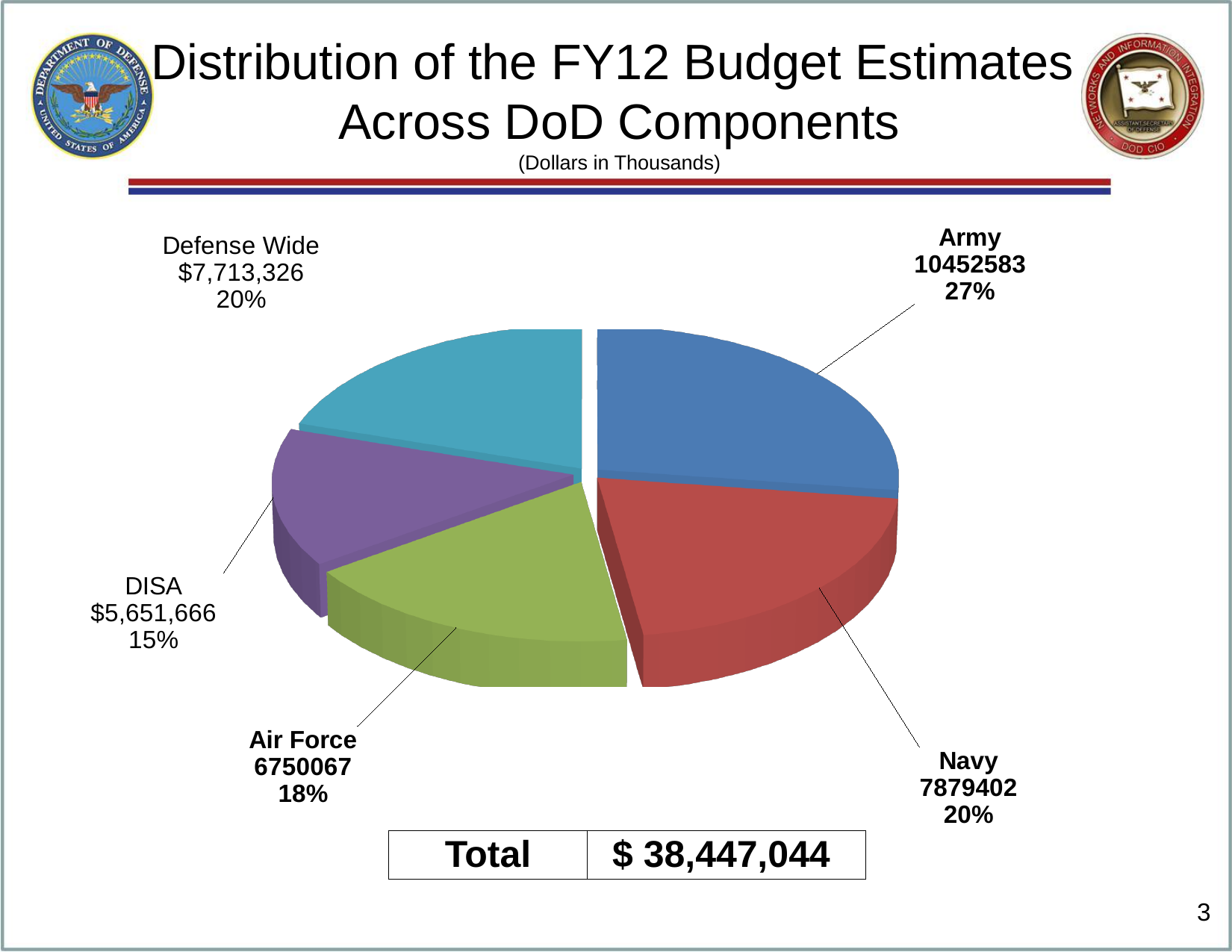
What is the budget estimate value shown for DISA? $5,651,666 What kind of chart is shown on the slide? pie chart What is the budget estimate value shown for Defense Wide? $7,713,326 Which component has the smallest share of the FY12 budget estimates? DISA How many components (slices) does the pie chart show? 5 What total is shown in the box below the pie chart? $ 38,447,044 What percentage share of the pie does the Air Force slice represent? 18% Which component has the largest share of the FY12 budget estimates? Army What is the budget estimate value shown for the Navy? 7879402 Which is larger, the Air Force value or the DISA value? Air Force What is the budget estimate value shown for the Army? 10452583 What is the difference between the Army value and the Navy value? 2573181